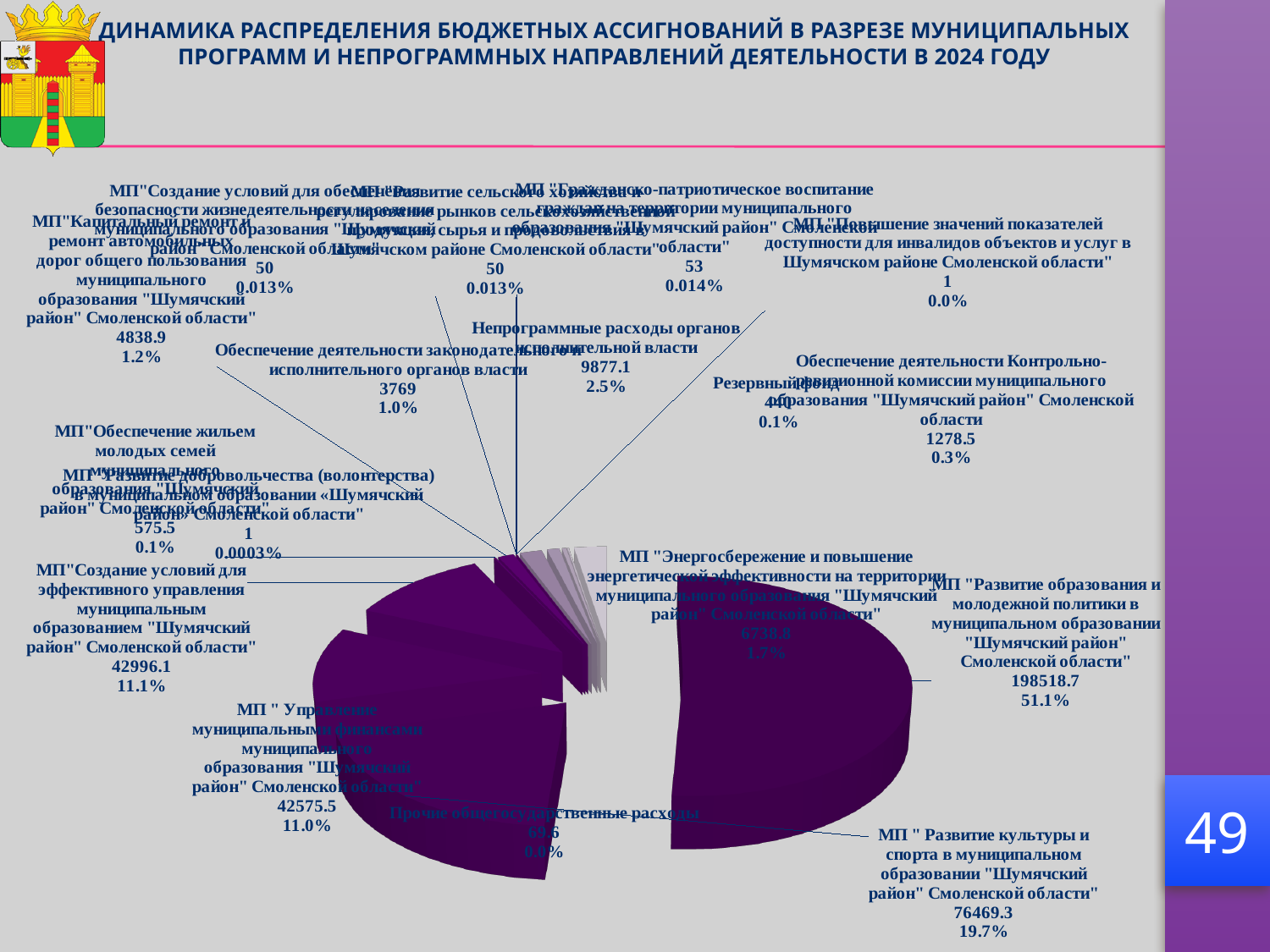
What share of the budget goes to МП "Развитие образования и молодежной политики в муниципальном образовании "Шумячский район" Смоленской области"? 51.1% What percentage is shown for Непрограммные расходы органов исполнительной власти? 2.5% Which is larger: the share for МП "Развитие культуры и спорта..." or the share for МП "Создание условий для эффективного управления муниципальным образованием..."? МП "Развитие культуры и спорта..." What is the difference between the values for МП "Создание условий для эффективного управления муниципальным образованием..." (42996.1) and МП "Управление муниципальными финансами..." (42575.5)? 420.6 What is the percentage shown for Обеспечение деятельности законодательного и исполнительного органов власти? 1.0% Which category has the largest share of the pie? МП "Развитие образования и молодежной политики в муниципальном образовании "Шумячский район" Смоленской области" What is the value shown for МП "Управление муниципальными финансами муниципального образования "Шумячский район" Смоленской области"? 42575.5 What is the value shown for МП "Развитие культуры и спорта в муниципальном образовании "Шумячский район" Смоленской области"? 76469.3 What value is shown for МП "Капитальный ремонт и ремонт автомобильных дорог общего пользования..."? 4838.9 What is the difference between the values for МП "Развитие образования и молодежной политики..." (198518.7) and МП "Развитие культуры и спорта..." (76469.3)? 122049.4 What share is shown for Обеспечение деятельности Контрольно-ревизионной комиссии муниципального образования "Шумячский район" Смоленской области? 0.3% What kind of chart is shown on the slide? pie chart